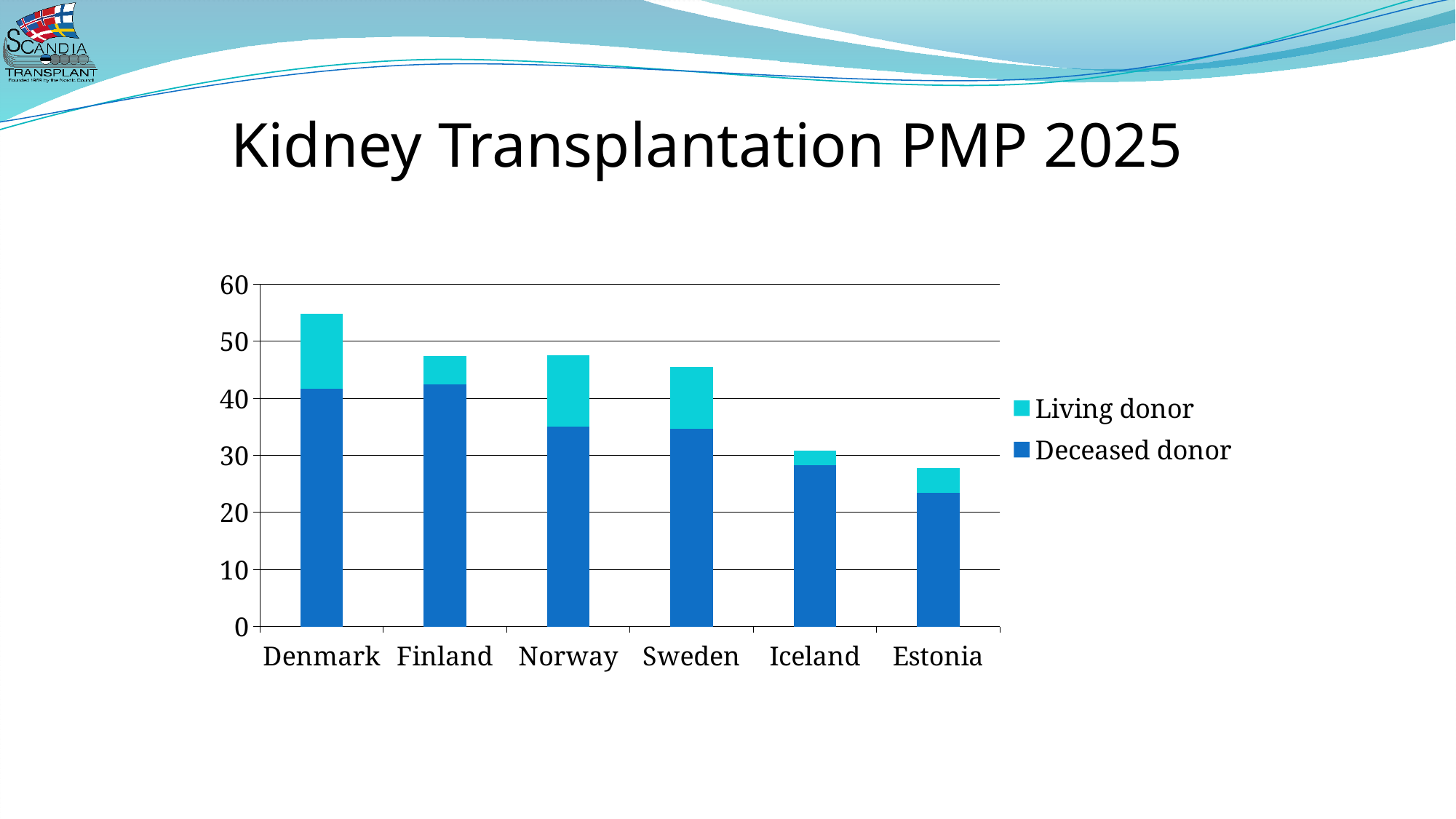
How many series does the legend list? 2 Which is larger, the total value for Iceland or for Estonia? Iceland How many countries are shown on the x axis of the chart? 6 Which country has the highest total kidney transplantation PMP? Denmark Is the deceased donor value for Sweden greater or less than 40? less Which country has the lowest deceased donor value? Estonia What kind of chart is shown on the slide? Stacked bar chart Is the total value for Denmark greater or less than 50? greater Is the total value for Estonia greater or less than 30? less Which country has the lowest total kidney transplantation PMP? Estonia Which is larger, the deceased donor value for Finland or for Norway? Finland What is the title of the slide? Kidney Transplantation PMP 2025